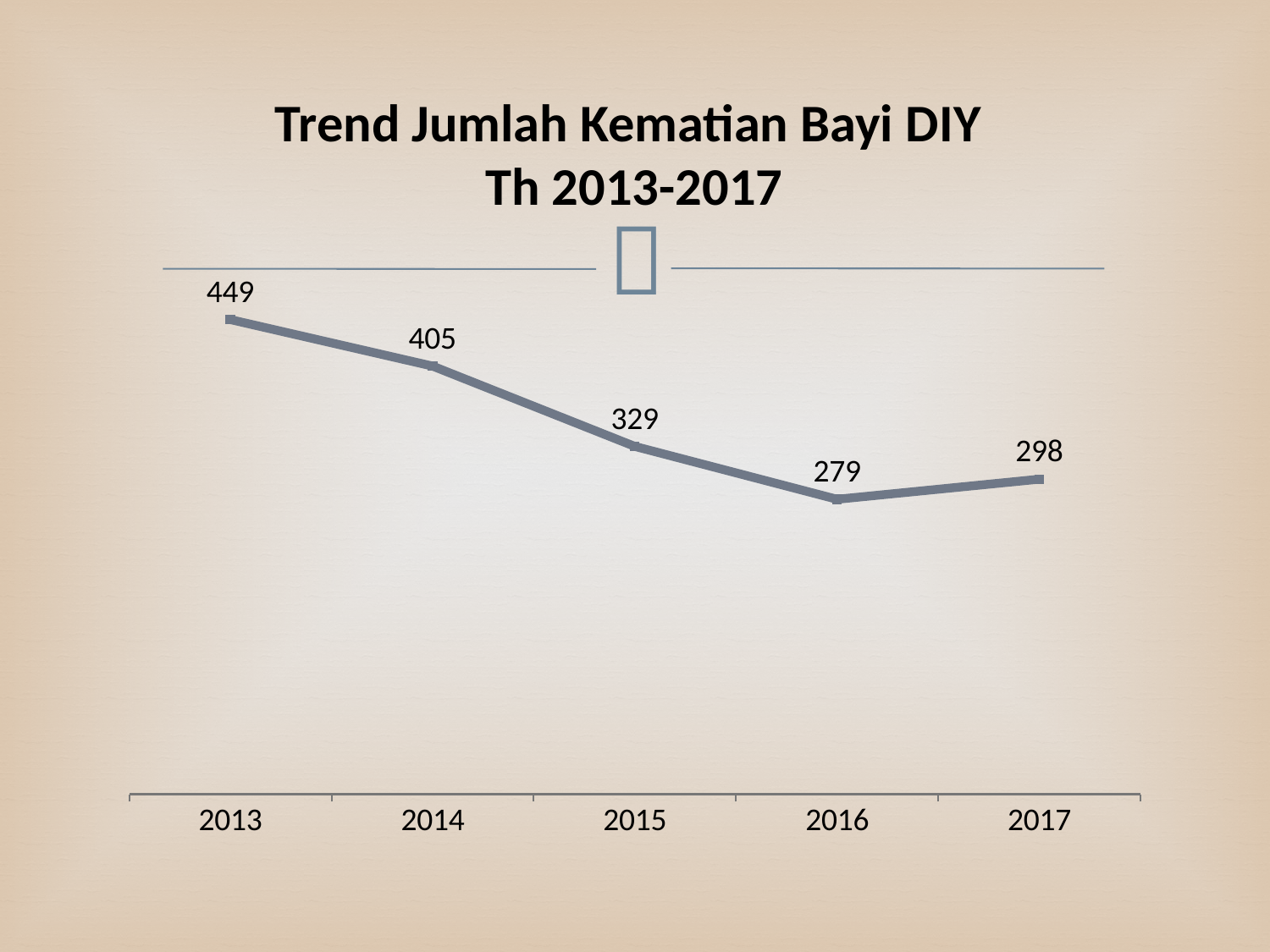
How many years are plotted on the chart? 5 What is the difference between the values for 2015 and 2016? 50 Which year has the lowest value? 2016 Do the values generally rise or fall from 2013 to 2016? fall What is the value for 2016? 279 What is the title of the chart? Trend Jumlah Kematian Bayi DIY Th 2013-2017 What is the value for 2017? 298 What kind of chart is shown on the slide? line chart What is the value for 2013? 449 What is the difference between the values for 2013 and 2014? 44 Which year has the highest value? 2013 Which is larger, the value for 2015 or the value for 2017? 2015